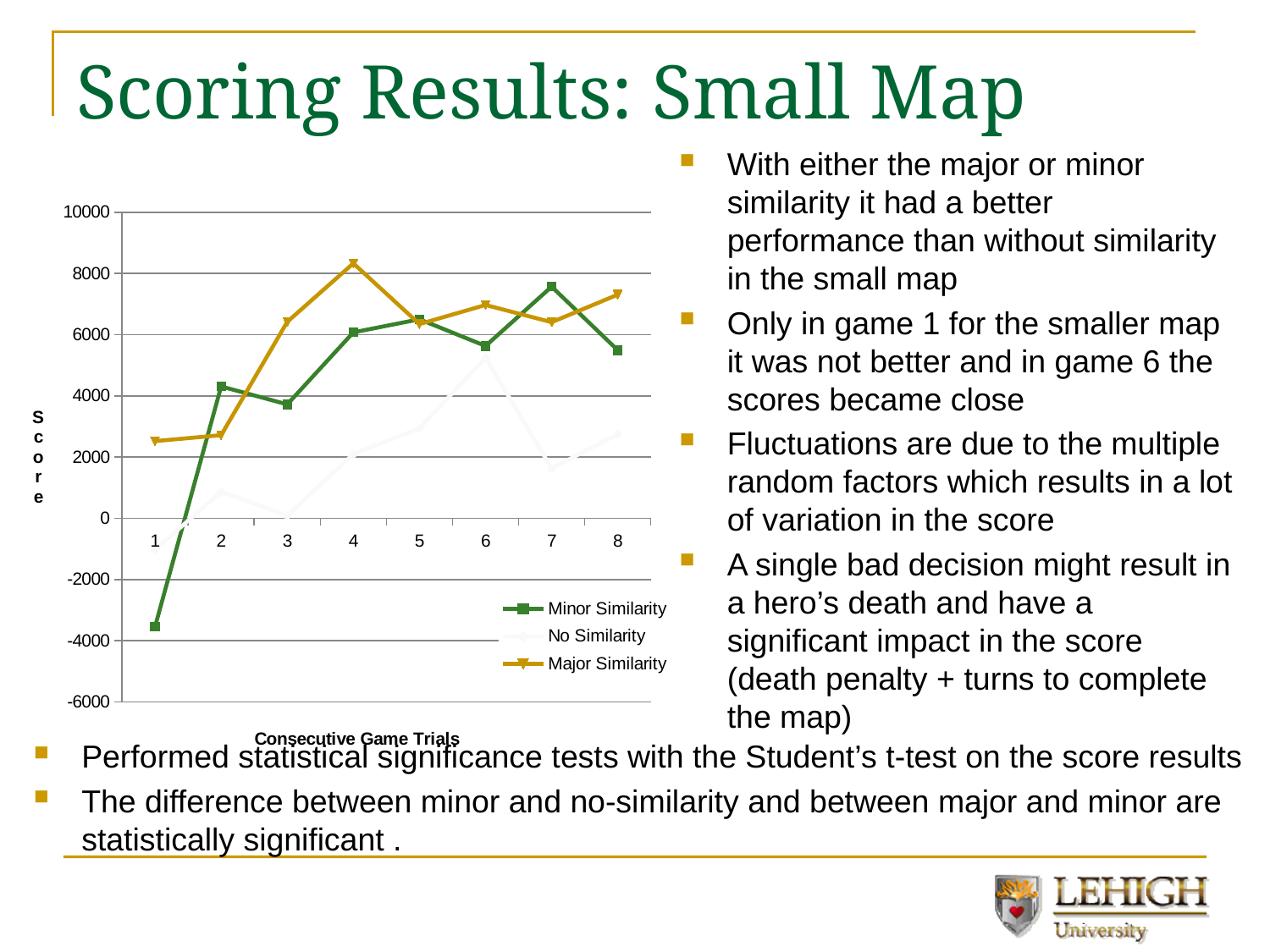
At which trial does the Minor Similarity series reach its highest score? 7 What is the title of the x axis of the chart? Consecutive Game Trials Is the Minor Similarity score at trial 1 greater or less than -2000? less How many series does the chart's legend list? 3 Is the Major Similarity score at trial 4 greater or less than 8000? greater At which trial does the Minor Similarity series have its lowest score? 1 What kind of chart is shown on the slide? line chart At which trial does the Major Similarity series reach its highest score? 4 Is the Minor Similarity score at trial 7 greater or less than 6000? greater How many consecutive game trials are plotted along the x axis? 8 At trial 1, which series has the higher score, Minor Similarity or Major Similarity? Major Similarity Does the Major Similarity score rise or fall from trial 1 to trial 4? rise